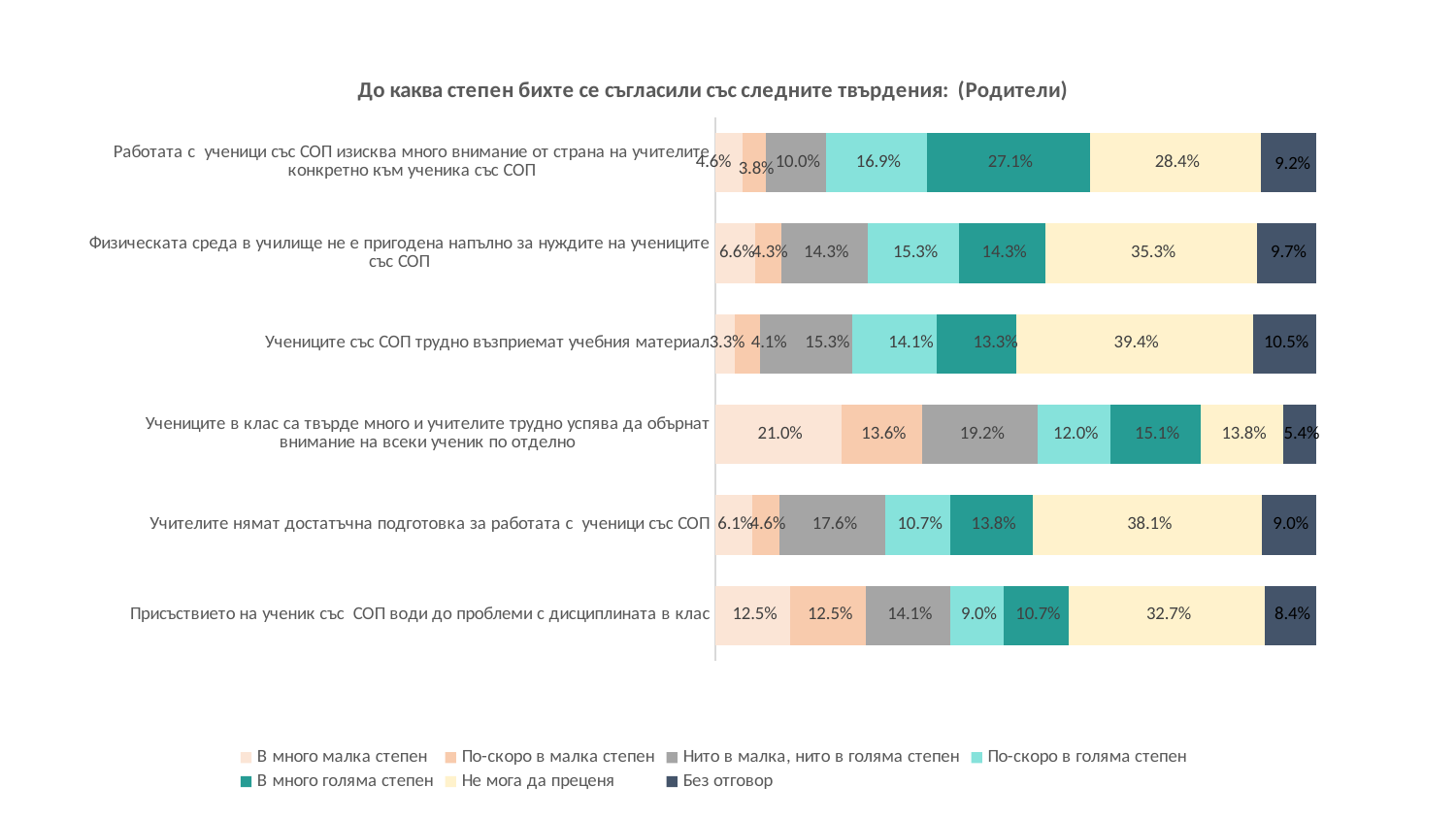
What is the value of 'Не мога да преценя' for the statement 'Учениците със СОП трудно възприемат учебния материал'? 39.4% How many series does the legend list? 7 What is the value of 'Без отговор' for the statement 'Присъствието на ученик със СОП води до проблеми с дисциплината в клас'? 8.4% What is the value of 'В много малка степен' for the statement 'Учениците в клас са твърде много и учителите трудно успява да обърнат внимание на всеки ученик по отделно'? 21.0% How many statements (categories) are shown in the chart? 6 Which is larger: 'Не мога да преценя' for 'Физическата среда в училище не е пригодена напълно за нуждите на учениците със СОП' or for 'Присъствието на ученик със СОП води до проблеми с дисциплината в клас'? Физическата среда в училище не е пригодена напълно за нуждите на учениците със СОП Which statement has the highest value for 'Не мога да преценя'? Учениците със СОП трудно възприемат учебния материал What type of chart is shown on the slide? Stacked bar chart Which statement has the lowest value for 'Без отговор'? Учениците в клас са твърде много и учителите трудно успява да обърнат внимание на всеки ученик по отделно For the statement 'Работата с ученици със СОП изисква много внимание от страна на учителите конкретно към ученика със СОП', what is the difference between 'Не мога да преценя' and 'Без отговор'? 19.2% What is the value of 'В много голяма степен' for the statement 'Работата с ученици със СОП изисква много внимание от страна на учителите конкретно към ученика със СОП'? 27.1% What is the title of the chart? До каква степен бихте се съгласили със следните твърдения: (Родители)